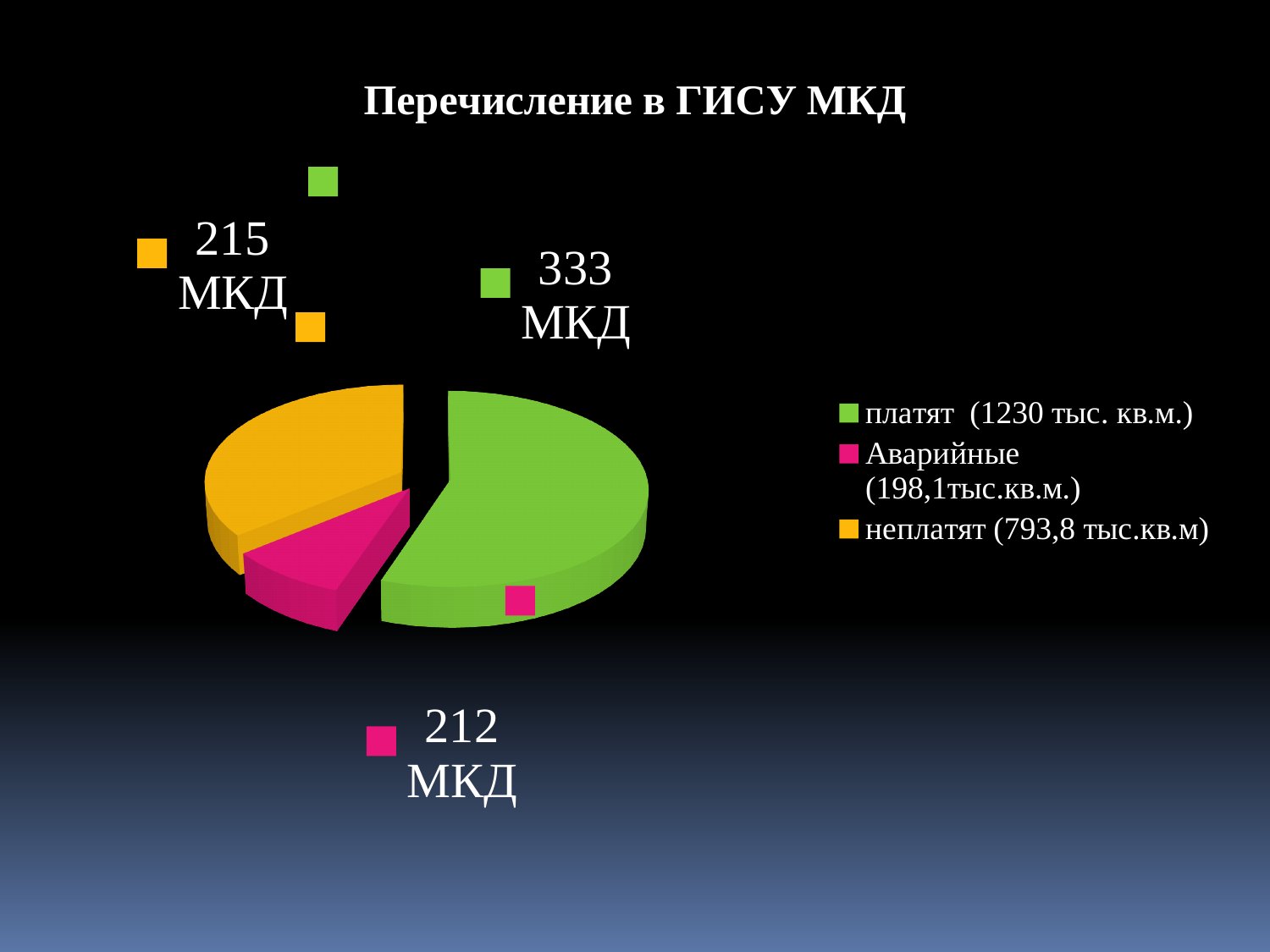
What is the difference in МКД between the платят label (333 МКД) and the Аварийные label (212 МКД)? 121 МКД What data label is shown on the yellow slice (неплатят)? 215 МКД Which category has the smallest slice of the pie? Аварийные Which category has the largest slice of the pie? платят According to the legend, what area is given for the category платят? 1230 тыс. кв.м. What type of chart is shown on the slide? pie chart How many slices does the pie chart have? 3 How many entries does the legend list? 3 What is the title of the chart? Перечисление в ГИСУ МКД What data label is shown on the green slice (платят)? 333 МКД What data label is shown on the pink slice (Аварийные)? 212 МКД According to the legend, what area is given for the category неплатят? 793,8 тыс.кв.м